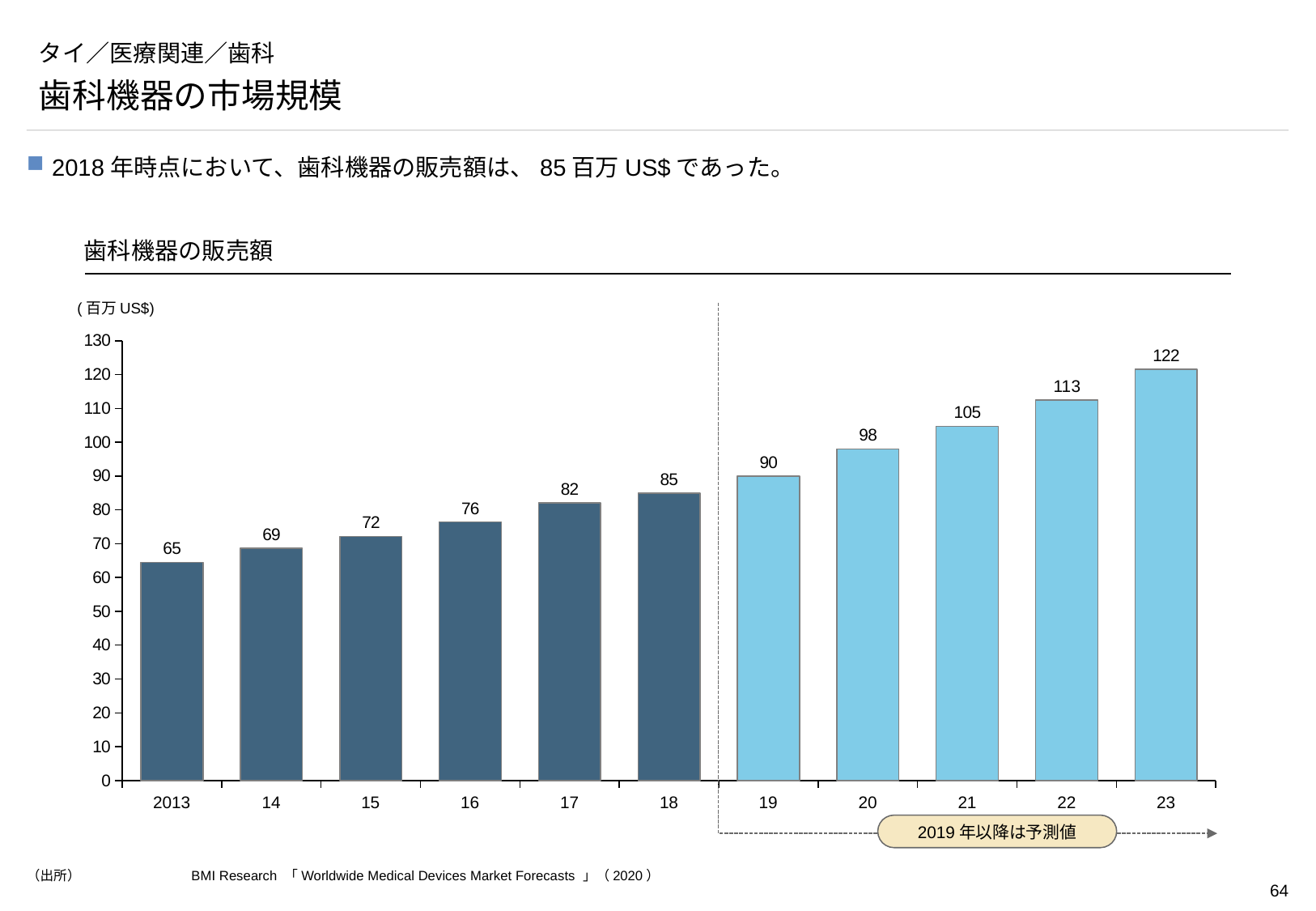
What is the forecast value for 23 (2023) in the chart? 122 How many years (bars) are shown in the chart? 11 Is the value for 21 greater or less than 100? greater Do the values rise or fall from 2013 to 23 along the x axis? rise Which year has the lowest value in the chart? 2013 What is the difference between the values for 23 and 2013? 57 Which year has the highest value in the chart? 23 What is the value for 2018 in the 歯科機器の販売額 chart? 85 Which is larger, the value for 20 or the value for 19? 20 What is the difference between the values for 18 and 17? 3 What is the value for 2013 in the chart? 65 What kind of chart is shown on the slide? bar chart